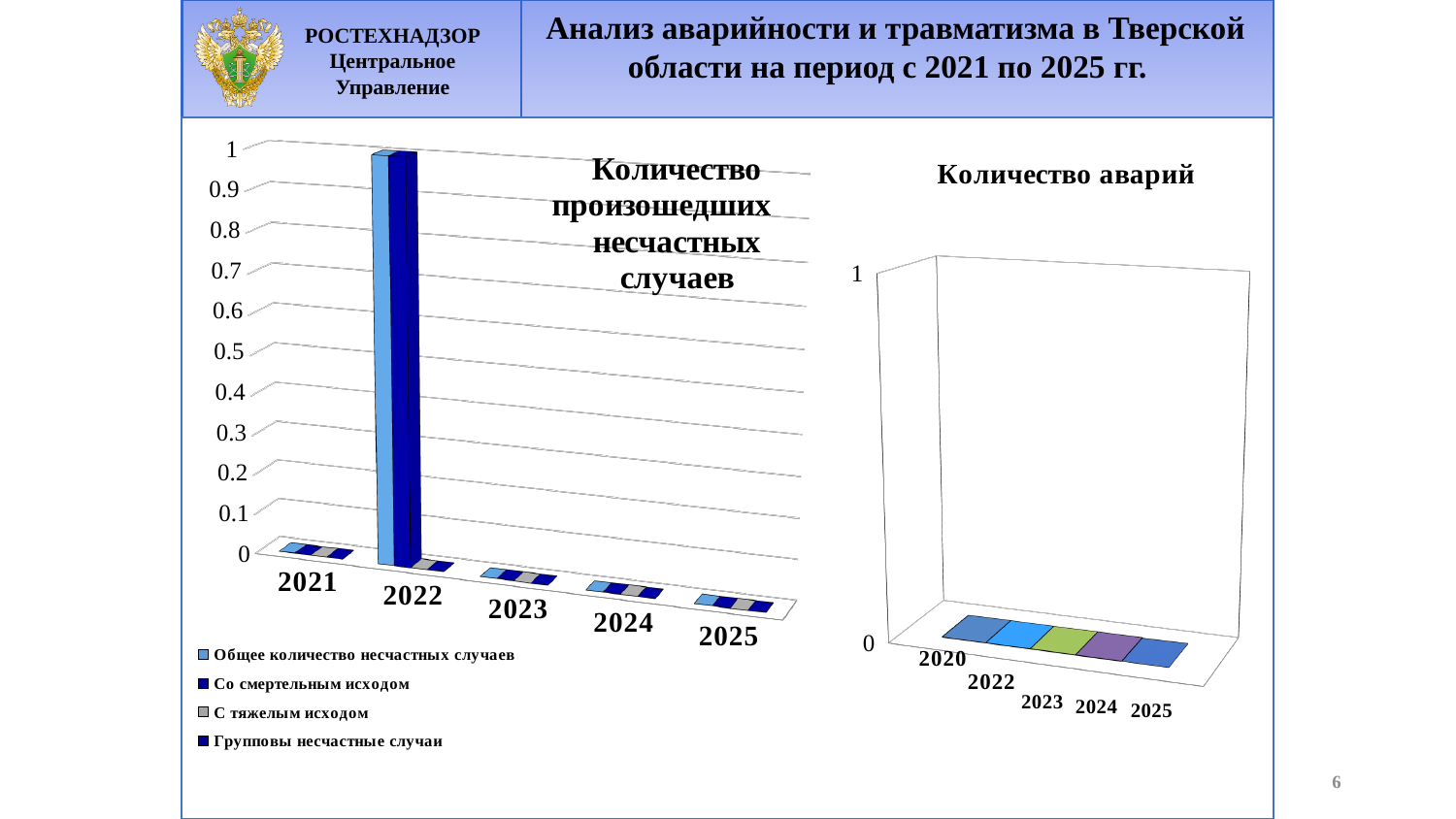
In the left chart «Количество произошедших несчастных случаев», what is the value of «Общее количество несчастных случаев» for 2022? 1 In the right chart «Количество аварий», how many years are shown on the x axis? 5 What kind of chart is the right chart titled «Количество аварий»? bar chart In the left chart «Количество произошедших несчастных случаев», how many series does the legend list? 4 In the left chart «Количество произошедших несчастных случаев», what is the value of «Общее количество несчастных случаев» for 2021? 0 In the right chart «Количество аварий», what is the value for 2023? 0 What kind of chart is the left chart titled «Количество произошедших несчастных случаев»? bar chart In the left chart «Количество произошедших несчастных случаев», which year has the highest value for «Общее количество несчастных случаев»? 2022 In the left chart «Количество произошедших несчастных случаев», how many years are shown on the x axis? 5 In the left chart «Количество произошедших несчастных случаев», what is the first entry in the legend? Общее количество несчастных случаев What is the title of the chart on the right side of the slide? Количество аварий In the left chart «Количество произошедших несчастных случаев», which is larger: the value of «Общее количество несчастных случаев» for 2022 or for 2023? 2022